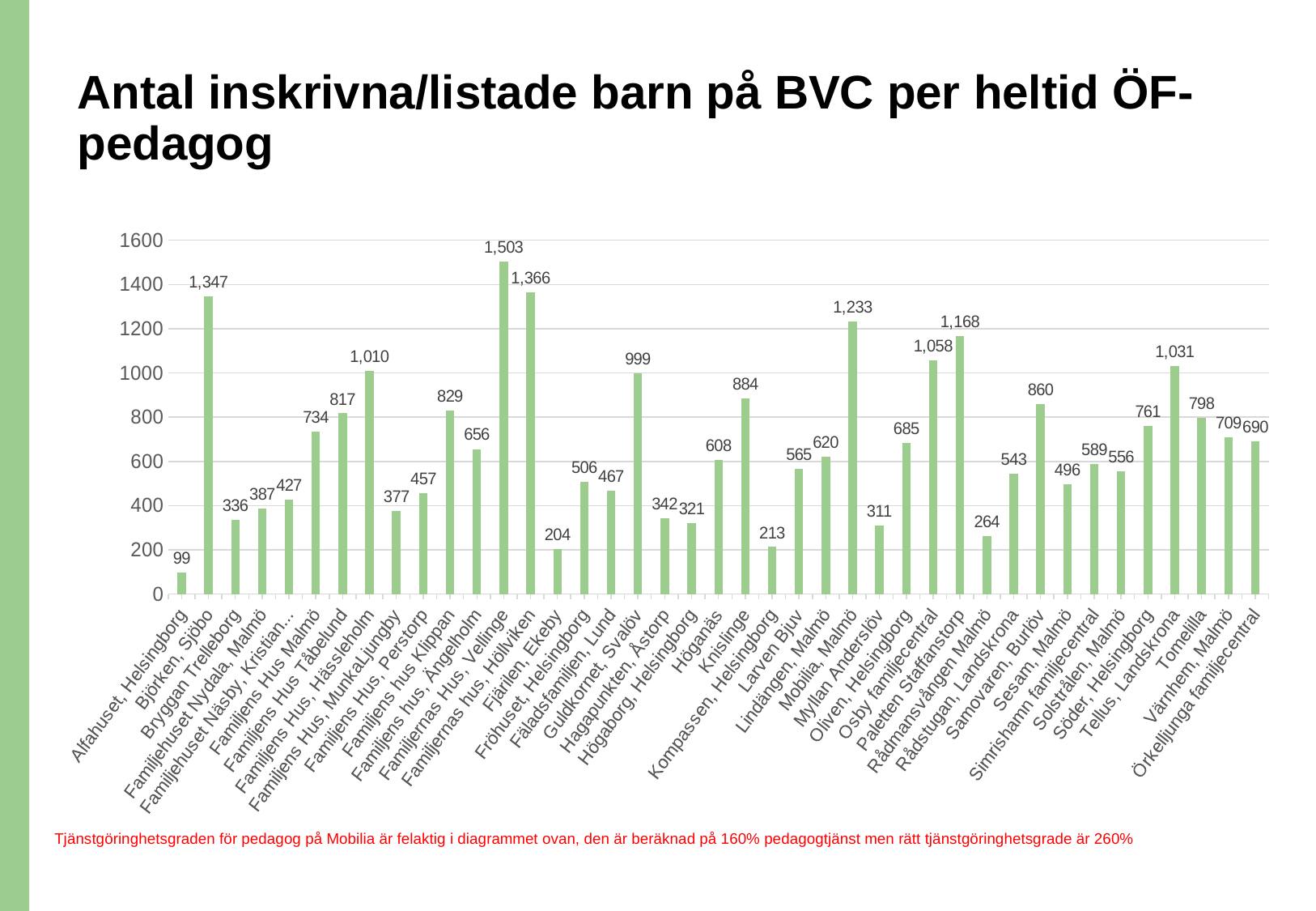
What is the title of the slide? Antal inskrivna/listade barn på BVC per heltid ÖF-pedagog Which category has the highest value? Familjernas Hus, Vellinge Which category has the lowest value? Alfahuset, Helsingborg Is the value for Paletten Staffanstorp greater or less than 1000? greater How many categories are shown on the x axis? 41 What kind of chart is shown on the slide? bar chart Which is larger, the value for Knislinge or the value for Samovaren, Burlöv? Knislinge What is the value for Guldkornet, Svalöv? 999 What is the difference between the values for Björken, Sjöbo and Bryggan Trelleborg? 1,011 What is the value for Tellus, Landskrona? 1,031 What is the value for Familjernas Hus, Vellinge? 1,503 What is the value for Mobilia, Malmö? 1,233